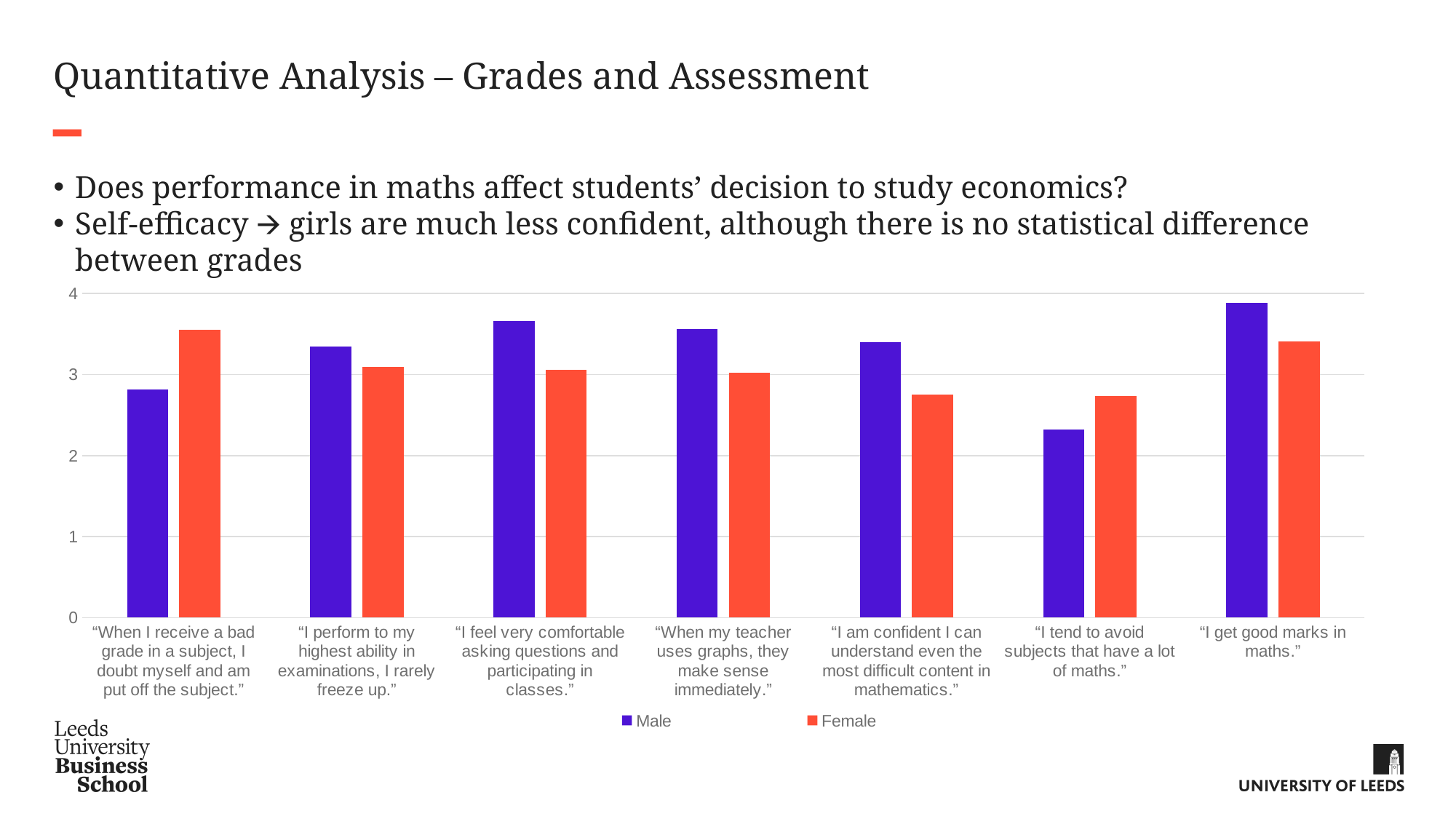
For the statement "When I receive a bad grade in a subject, I doubt myself and am put off the subject.", which is larger, the Male or the Female value? Female What kind of chart is shown on the slide? bar chart For which statement is the Male value highest? "I get good marks in maths." Which series is shown in purple according to the legend? Male How many series does the legend list? 2 Is the Male value for "I tend to avoid subjects that have a lot of maths." greater or less than 3? less For which statement is the Male value lowest? "I tend to avoid subjects that have a lot of maths." For the statement "I feel very comfortable asking questions and participating in classes.", which is larger, the Male or the Female value? Male How many statement categories are plotted on the x axis? 7 Is the Female value for "When I receive a bad grade in a subject, I doubt myself and am put off the subject." greater or less than 3? greater Which series is shown in orange-red according to the legend? Female For which statement is the Female value highest? "When I receive a bad grade in a subject, I doubt myself and am put off the subject."